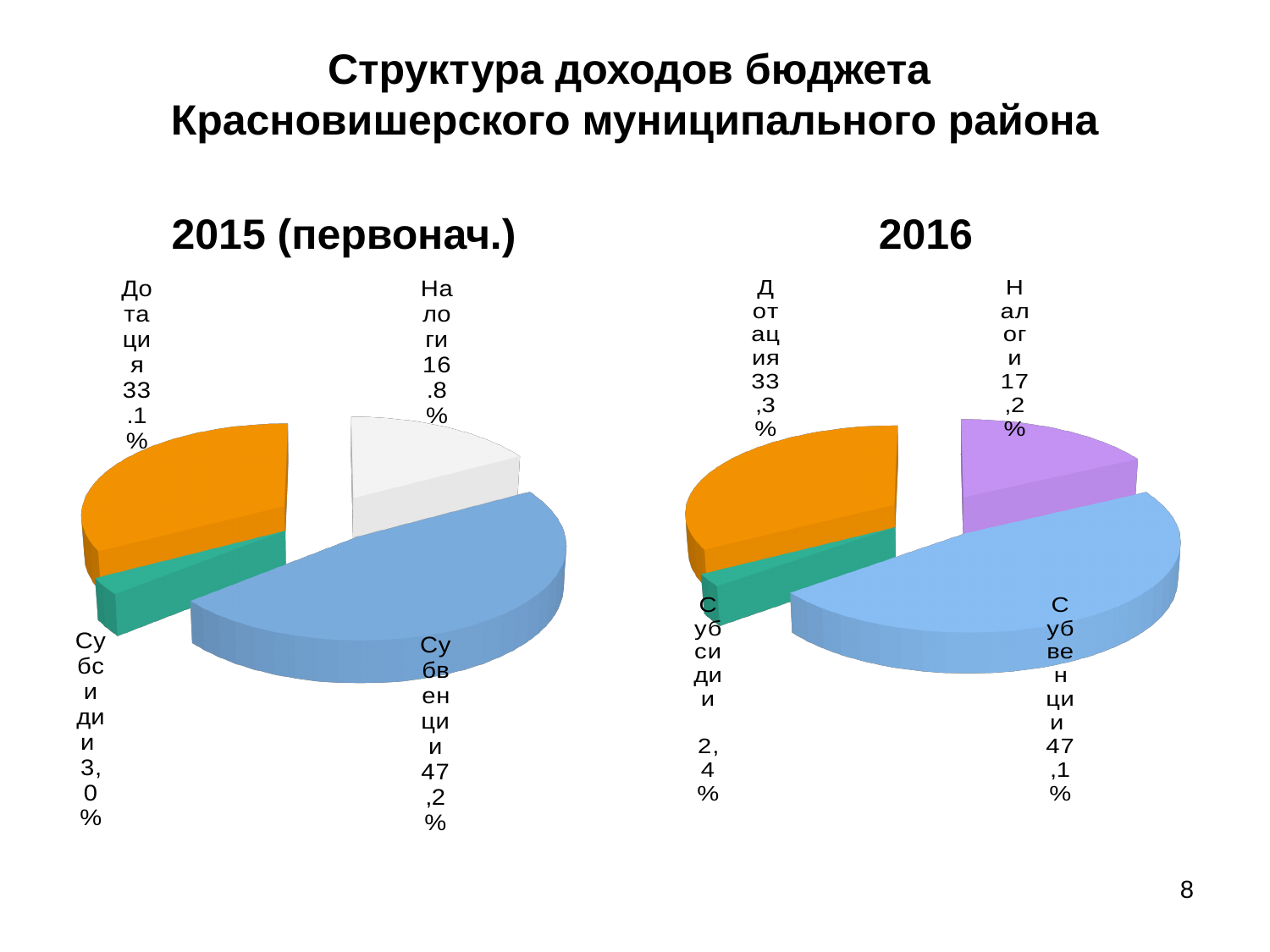
In the 2016 chart, what share is labelled for Субсидии? 2,4% In the 2016 chart, what is the difference between the Субвенции share and the Налоги share? 29,9% In the 2015 (первонач.) chart, which category has the smallest slice? Субсидии In the 2015 (первонач.) chart, what share is labelled for Субвенции? 47,2% In the 2015 (первонач.) chart, what share is labelled for Налоги? 16.8% How many slices does the 2016 chart have? 4 In the 2016 chart, which category has the largest slice? Субвенции In the 2016 chart, what share is labelled for Дотация? 33,3% In the 2015 (первонач.) chart, what share of the pie is Дотация? 33.1% What is the title of the slide? Структура доходов бюджета Красновишерского муниципального района What type of chart is used for 2015 (первонач.)? Pie chart In the 2015 (первонач.) chart, which is larger: Дотация or Налоги? Дотация